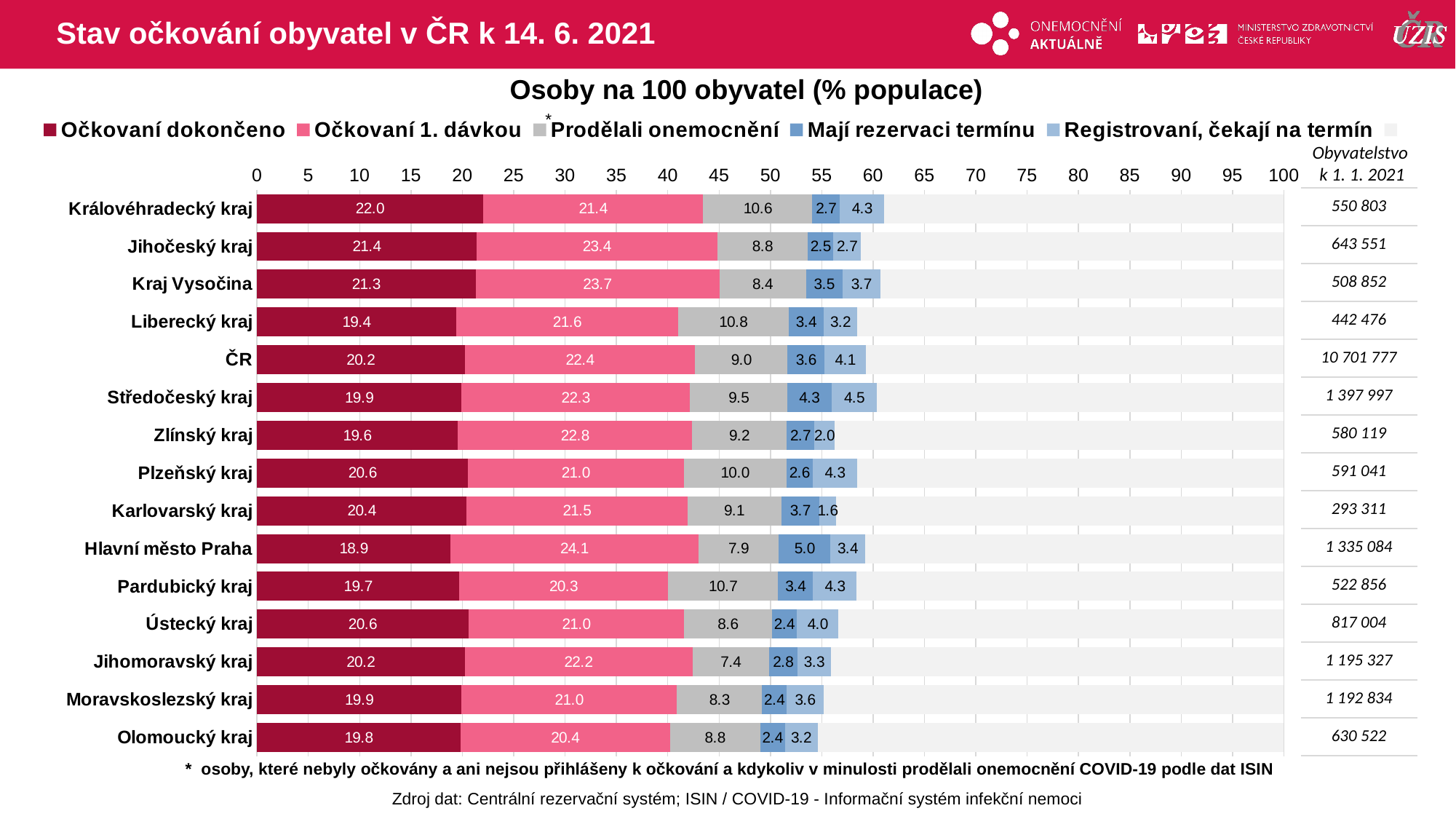
What is the value of Mají rezervaci termínu for Hlavní město Praha? 5.0 Which region has the lowest value for Registrovaní, čekají na termín? Karlovarský kraj Which region has the lowest value for Očkovaní dokončeno? Hlavní město Praha What is the value of Očkovaní dokončeno for Královéhradecký kraj? 22.0 How many rows (regions including ČR) are plotted in the chart? 15 Which region has the highest value for Očkovaní dokončeno? Královéhradecký kraj What is the value of Prodělali onemocnění for ČR? 9.0 What is the value of Očkovaní 1. dávkou for Hlavní město Praha? 24.1 What kind of chart is shown on the slide? Stacked horizontal bar chart Which has the larger Očkovaní 1. dávkou value, Jihočeský kraj or Kraj Vysočina? Kraj Vysočina What is the difference between the Očkovaní dokončeno values for Královéhradecký kraj and Hlavní město Praha? 3.1